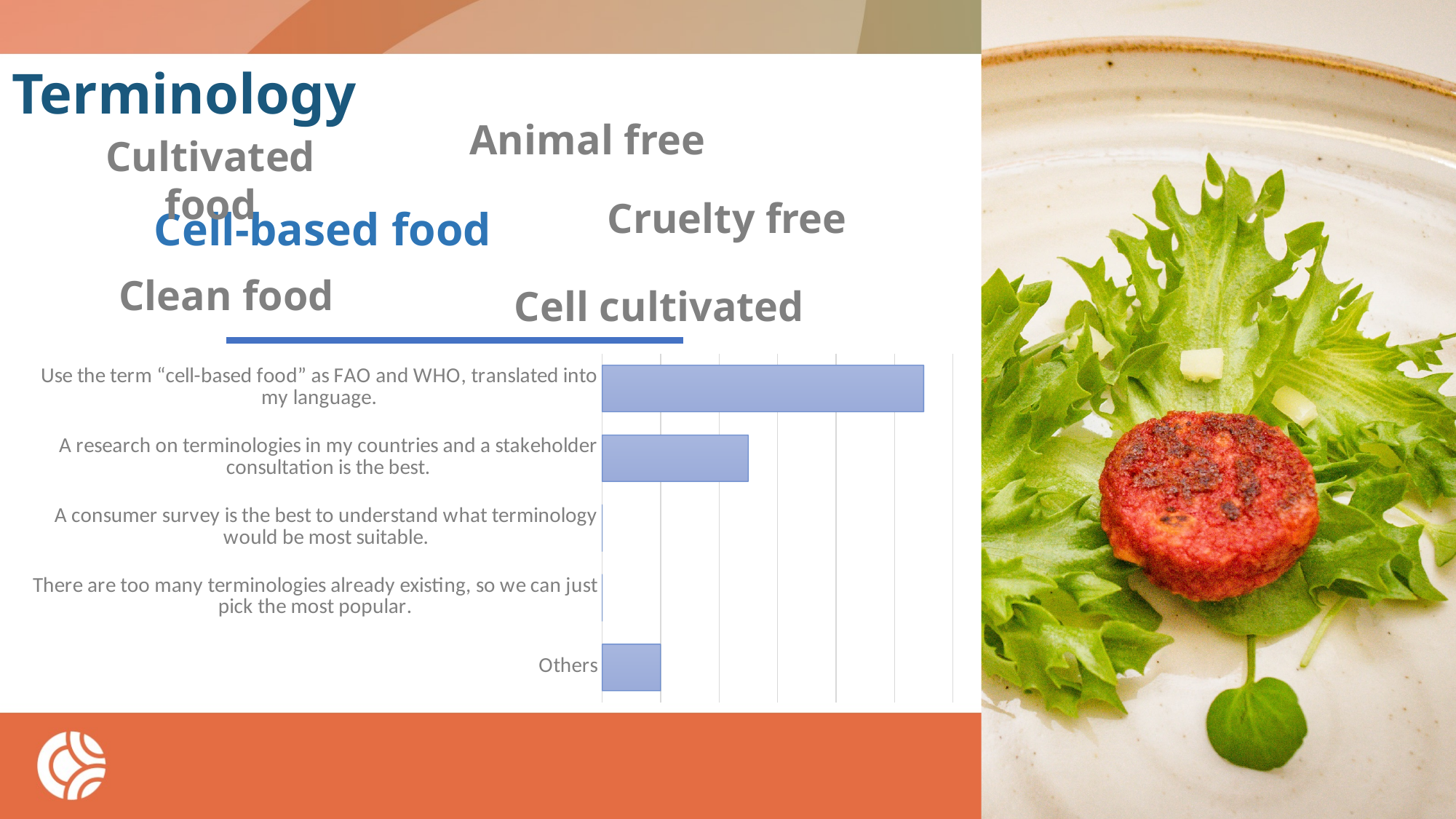
What colour are the bars in the chart? Blue What kind of chart is shown on the slide? Bar chart Which category is the last (bottom) one listed in the chart? Others How many categories does the bar chart show? 5 Which bar is longer: "Others" or "A consumer survey is the best to understand what terminology would be most suitable."? Others Are the bars in the chart drawn horizontally or vertically? Horizontally Which bar is longer: "Use the term "cell-based food" as FAO and WHO, translated into my language." or "A research on terminologies in my countries and a stakeholder consultation is the best."? Use the term "cell-based food" as FAO and WHO, translated into my language. Which bar is longer: "Others" or "A research on terminologies in my countries and a stakeholder consultation is the best."? A research on terminologies in my countries and a stakeholder consultation is the best. Which category has the longest bar in the chart? Use the term "cell-based food" as FAO and WHO, translated into my language.